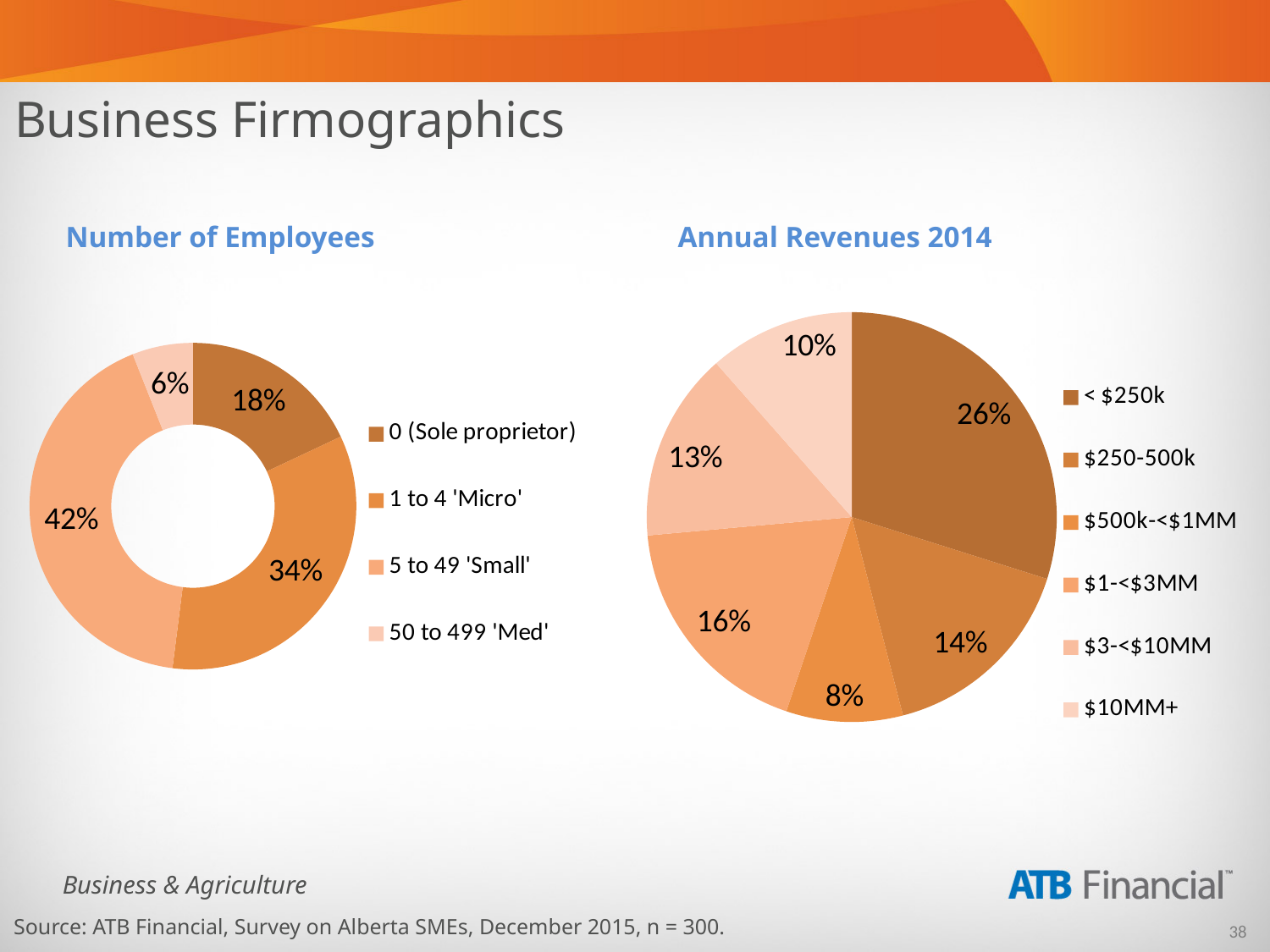
In the Annual Revenues 2014 chart, what share of businesses had revenues of $1-<$3MM? 16% In the Number of Employees chart, which category has the largest share? 5 to 49 'Small' In the Number of Employees chart, which category has the smallest share? 50 to 499 'Med' How many categories does the Number of Employees chart show? 4 In the Annual Revenues 2014 chart, which revenue category has the smallest share? $500k-<$1MM In the Annual Revenues 2014 chart, which is larger: the share for $3-<$10MM or the share for $10MM+? $3-<$10MM In the Annual Revenues 2014 chart, which revenue category has the largest share? < $250k In the Number of Employees chart, what share of businesses have 5 to 49 'Small' employees? 42% How many categories does the legend of the Annual Revenues 2014 chart list? 6 In the Number of Employees chart, what share of businesses are 0 (Sole proprietor)? 18% What kind of chart is the Number of Employees chart? Donut chart In the Number of Employees chart, what is the difference between the 1 to 4 'Micro' share and the 50 to 499 'Med' share? 28%